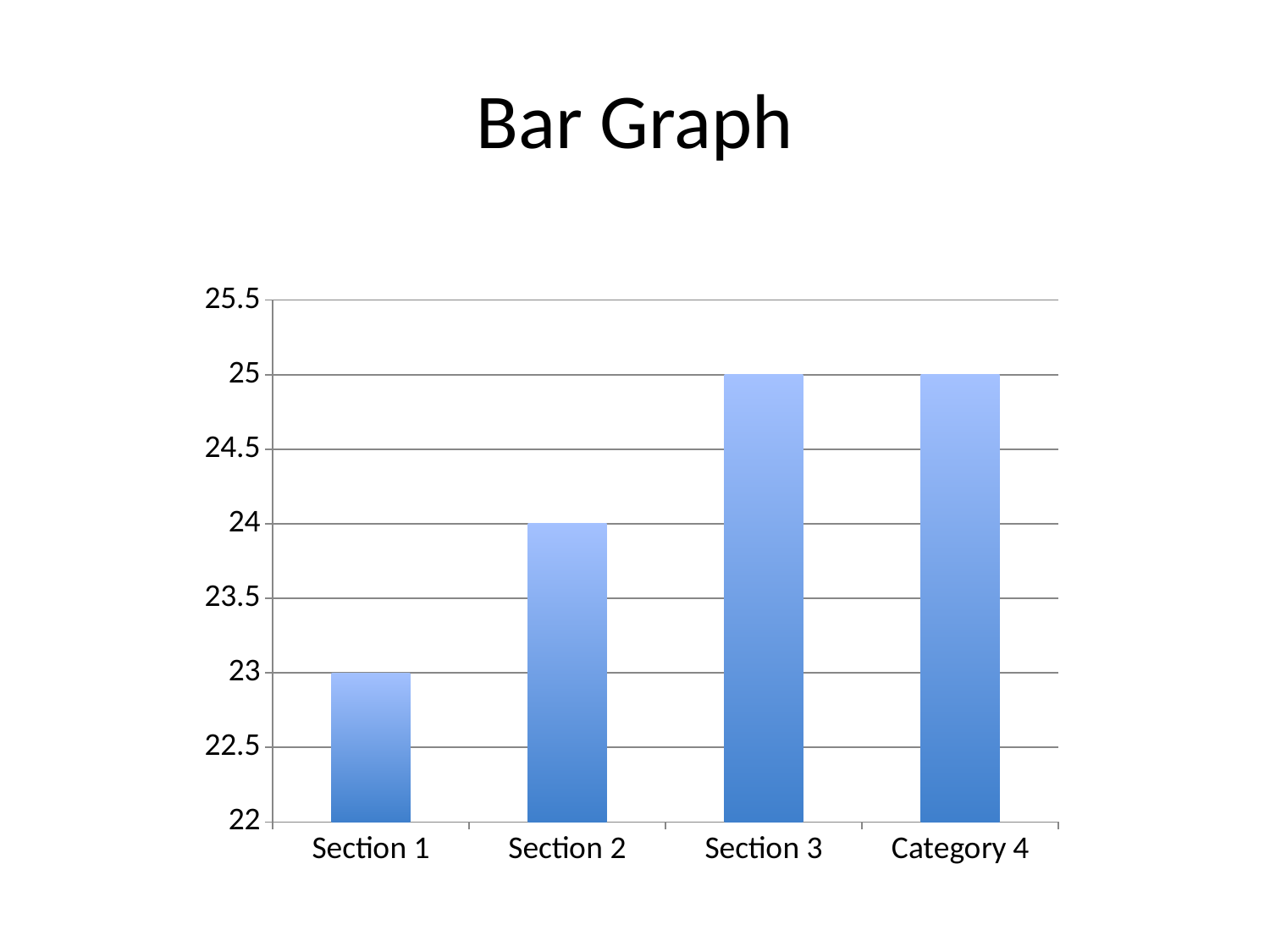
What is the difference between the values for Section 3 and Section 1? 2 What is the value for Section 1? 23 How many categories are shown on the x axis? 4 What is the value for Category 4? 25 Which is larger, the value for Section 2 or the value for Section 1? Section 2 What is the value for Section 2? 24 What is the value for Section 3? 25 What kind of chart is shown on the slide? bar chart Which category has the lowest value? Section 1 What is the difference between the values for Section 2 and Section 1? 1 What is the title of the slide? Bar Graph Is the value for Section 1 greater or less than 23.5? less